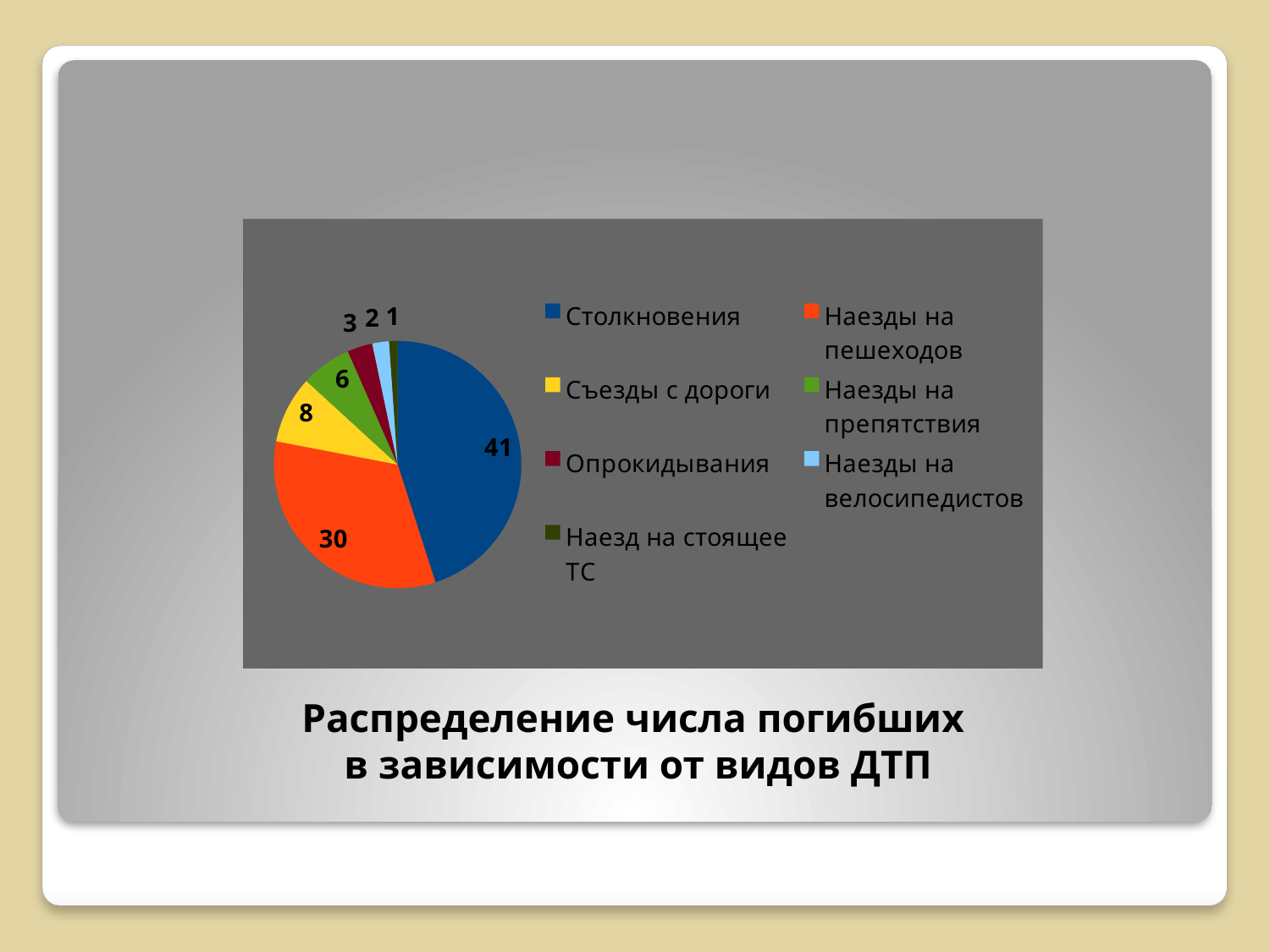
What is the value for Наезды на пешеходов? 30 Which category has the smallest slice of the pie? Наезд на стоящее ТС What is the value for Столкновения? 41 What kind of chart is shown on the slide? Pie chart What is the title written below the chart? Распределение числа погибших в зависимости от видов ДТП Which is larger, the value for Съезды с дороги or the value for Наезды на препятствия? Съезды с дороги What is the value for Съезды с дороги? 8 How many categories does the pie chart have? 7 Which category has the largest slice of the pie? Столкновения What is the value for Опрокидывания? 3 What is the value for Наезды на препятствия? 6 What is the difference between the values for Столкновения and Наезды на пешеходов? 11